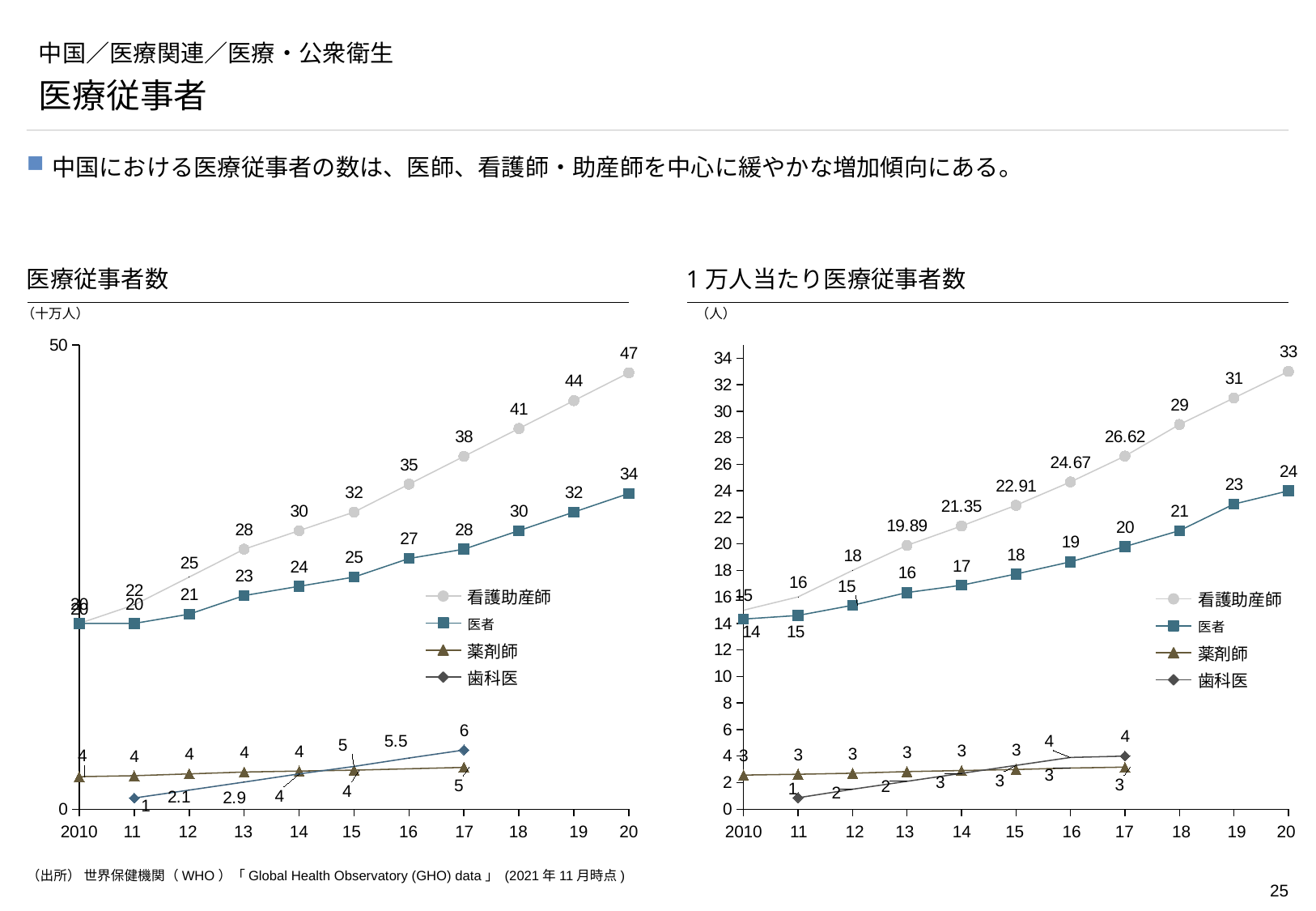
In the right chart (1万人当たり医療従事者数), what is the value for 看護助産師 in 17? 26.62 In the right chart (1万人当たり医療従事者数), is the value for 医者 in 20 greater or less than 20? greater In the left chart (医療従事者数), what is the value for 歯科医 in 13? 2.9 In the left chart (医療従事者数), what is the value for 医者 in 17? 28 In the right chart (1万人当たり医療従事者数), what is the value for 医者 in 2010? 14 In the right chart (1万人当たり医療従事者数), what is the difference between 看護助産師 and 医者 in 20? 9 In the left chart (医療従事者数), which series has the highest value in 20? 看護助産師 What kind of chart is the left chart (医療従事者数)? line chart In the left chart (医療従事者数), what is the value for 看護助産師 in 20? 47 In the left chart (医療従事者数), how many series does the legend list? 4 In the left chart (医療従事者数), what is the difference between 看護助産師 and 医者 in 20? 13 In the right chart (1万人当たり医療従事者数), does the value for 看護助産師 rise or fall from 2010 to 20? rise